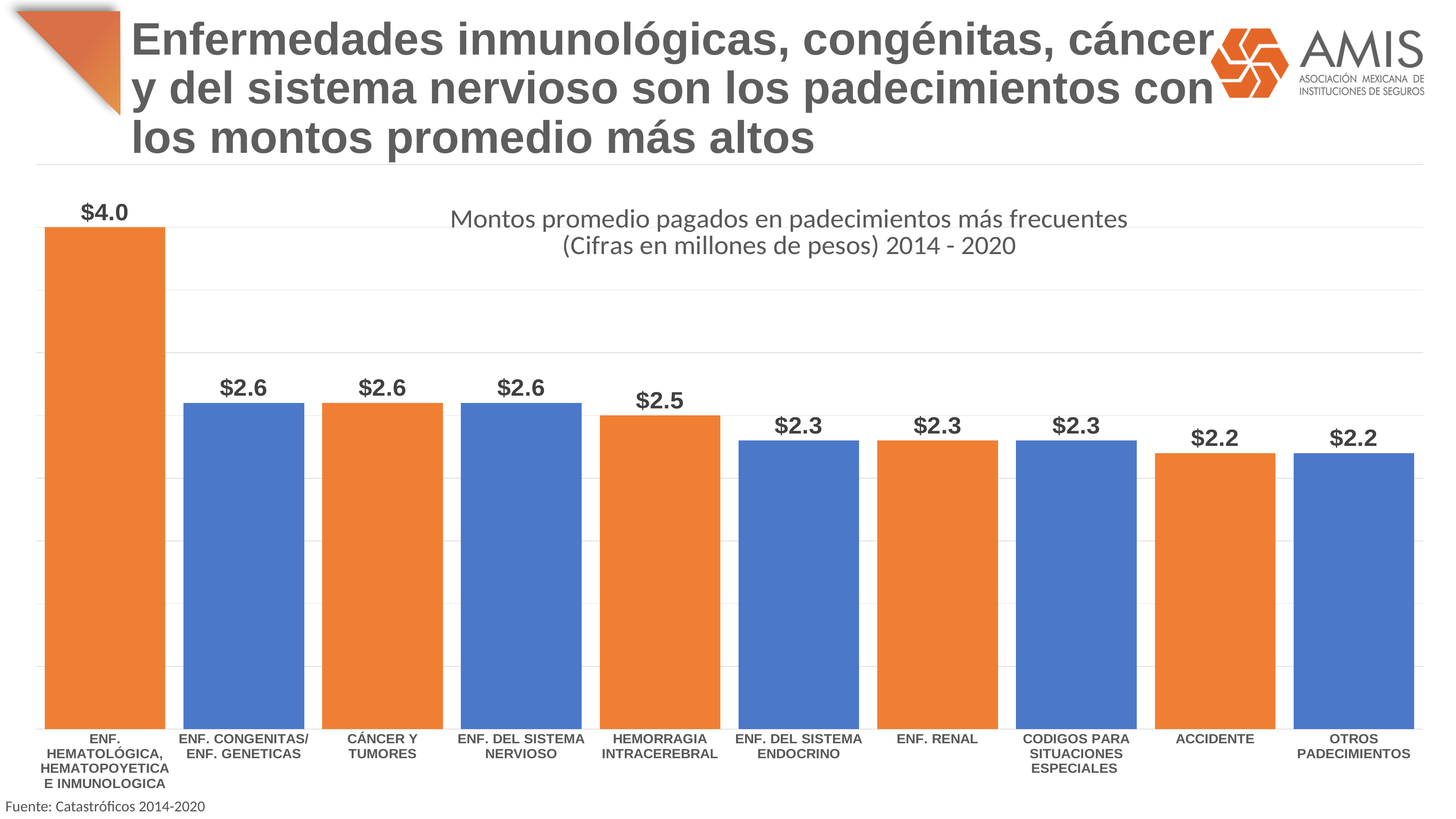
What is the value shown for CÁNCER Y TUMORES? $2.6 Do the values rise or fall moving from left to right across the chart? Fall What is the value shown for HEMORRAGIA INTRACEREBRAL? $2.5 What is the average amount paid for ENF. HEMATOLÓGICA, HEMATOPOYETICA E INMUNOLOGICA? $4.0 What is the difference between the value for ENF. HEMATOLÓGICA, HEMATOPOYETICA E INMUNOLOGICA and the value for ENF. DEL SISTEMA NERVIOSO? $1.4 What is the value shown for ACCIDENTE? $2.2 What is the value shown for ENF. RENAL? $2.3 What kind of chart is shown on the slide? Bar chart What is the difference between the value for ENF. CONGENITAS/ENF. GENETICAS and the value for OTROS PADECIMIENTOS? $0.4 Which category has the highest average amount paid? ENF. HEMATOLÓGICA, HEMATOPOYETICA E INMUNOLOGICA How many categories are shown in the chart? 10 Which is larger, the value for ENF. DEL SISTEMA NERVIOSO or the value for ENF. DEL SISTEMA ENDOCRINO? ENF. DEL SISTEMA NERVIOSO